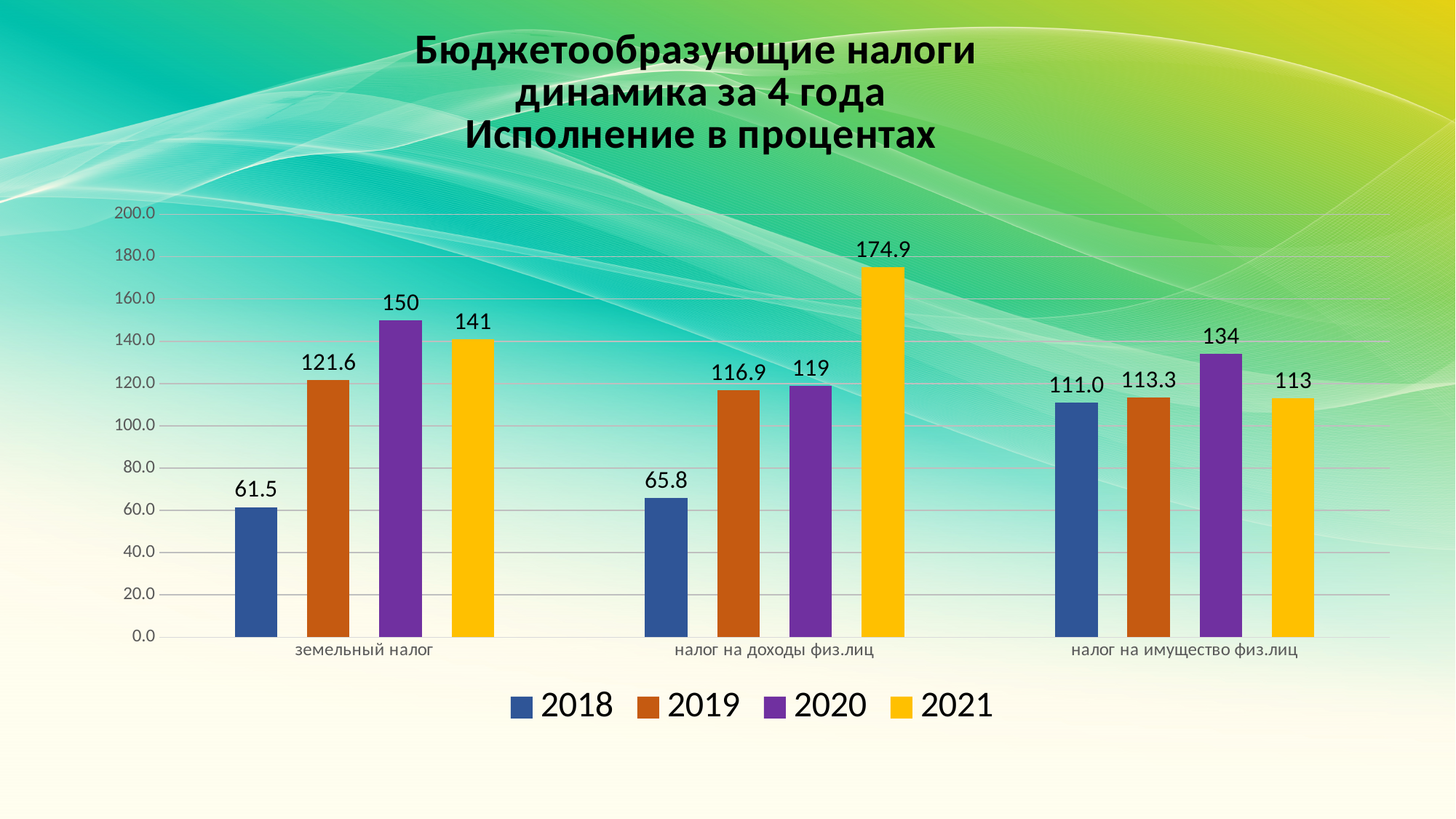
What is the difference between the 2020 and 2019 values for земельный налог? 28.4 Which is larger for налог на имущество физ.лиц: the 2020 value or the 2021 value? 2020 What is the value for 2018 for земельный налог? 61.5 Which year has the highest value for налог на доходы физ.лиц? 2021 How many series does the legend list? 4 Which colour represents the 2021 series in the legend? yellow Which year has the lowest value for земельный налог? 2018 What is the value for 2021 for налог на доходы физ.лиц? 174.9 What is the value for 2020 for земельный налог? 150 How many categories are shown on the x axis? 3 What is the value for 2019 for налог на имущество физ.лиц? 113.3 What kind of chart is shown on the slide? bar chart